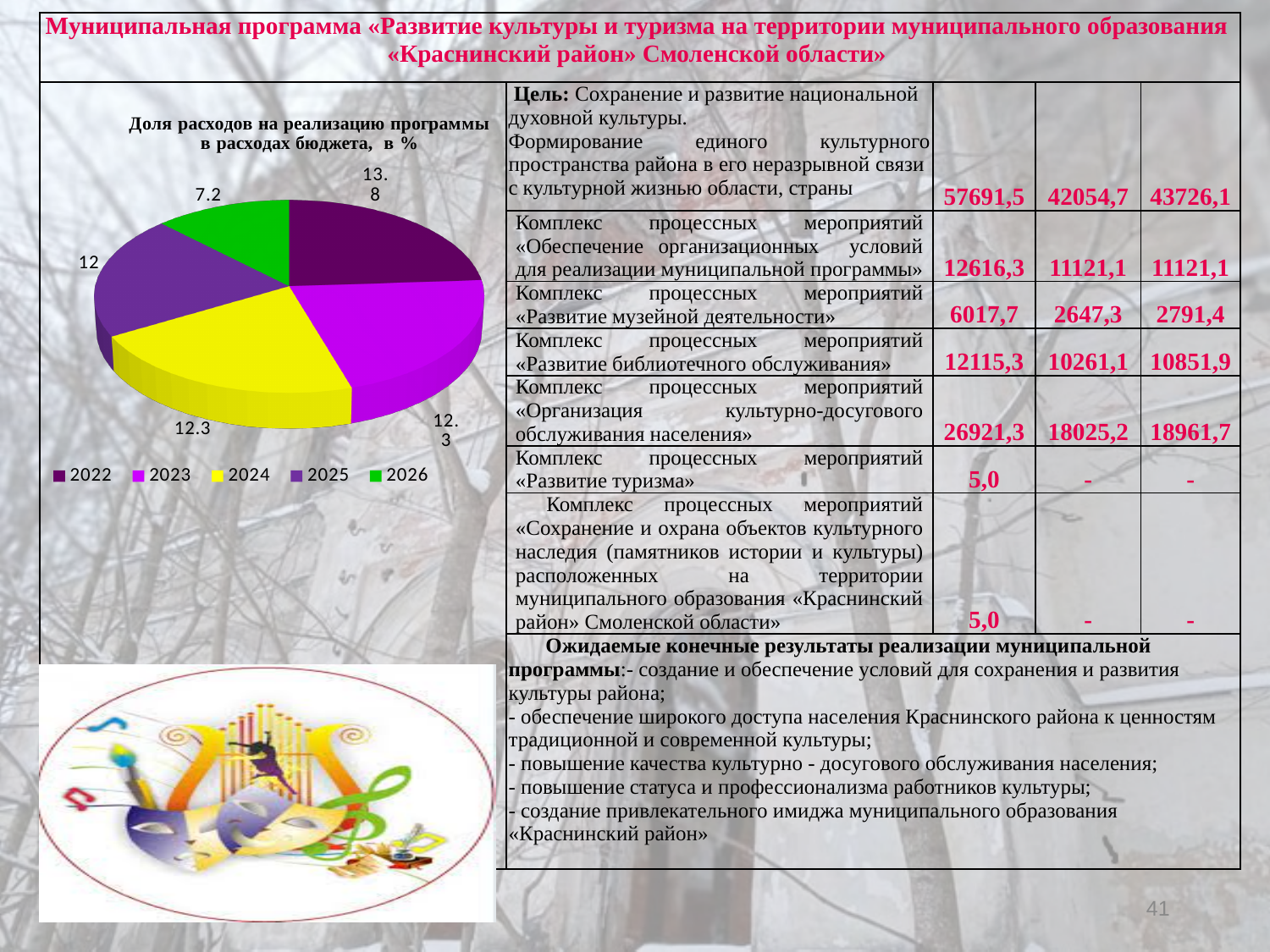
What is the difference between the values for 2022 and 2026 in the pie chart? 6.6 Which is larger in the pie chart, the value for 2025 or the value for 2026? 2025 Which year has the smallest slice in the pie chart? 2026 Which year has the largest slice in the pie chart? 2022 What value is shown for 2025 in the pie chart? 12 What value is shown for 2023 in the pie chart? 12.3 What value is shown for 2026 in the pie chart? 7.2 What value is shown for 2022 in the pie chart? 13.8 How many slices does the pie chart have? 5 What type of chart is shown on the slide? pie chart How many entries does the legend of the pie chart list? 5 What is the title of the pie chart? Доля расходов на реализацию программы в расходах бюджета, в %